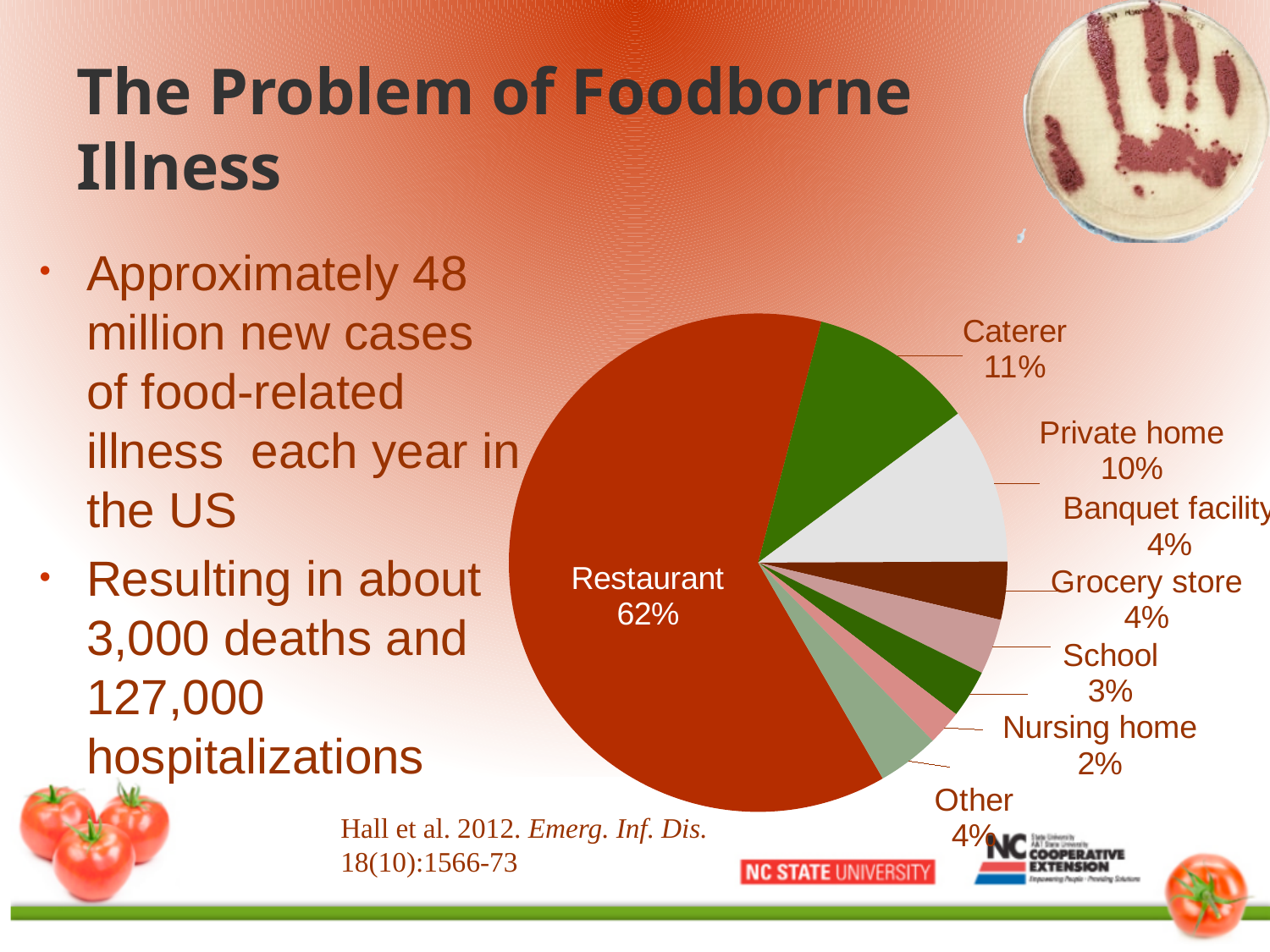
What is the value shown for Nursing home? 2% How many categories are shown in the pie chart? 8 Which is larger, the Caterer slice or the Private home slice? Caterer What is the value shown for Caterer? 11% What type of chart is shown on the slide? pie chart Which category has the smallest slice of the pie? Nursing home What is the difference between the Restaurant and Caterer percentages? 51% Which category has the largest slice of the pie? Restaurant What is the value shown for School? 3% What is the difference between the Private home and School percentages? 7% What share of the pie does Restaurant account for? 62% What is the value shown for Private home? 10%